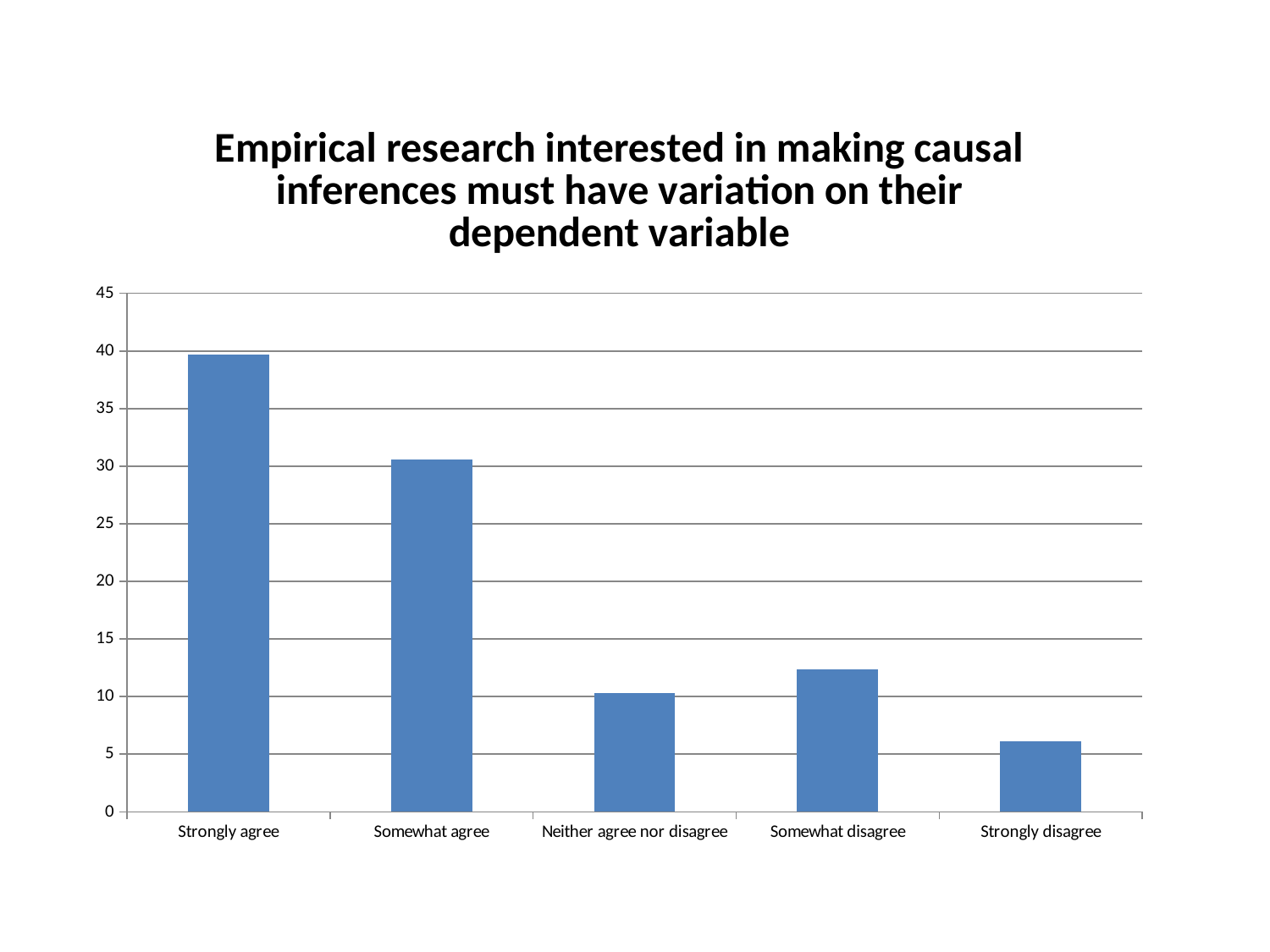
What kind of chart is shown on the slide? bar chart Is the value for Somewhat agree greater or less than 25? greater Is the value for Strongly agree greater or less than 35? greater What is the title of the chart? Empirical research interested in making causal inferences must have variation on their dependent variable Is the value for Somewhat disagree greater or less than 10? greater Which category has the highest value? Strongly agree Which is larger, the value for Strongly agree or the value for Somewhat agree? Strongly agree Which category has the lowest value? Strongly disagree Which is larger, the value for Somewhat disagree or the value for Neither agree nor disagree? Somewhat disagree How many categories are shown on the x axis? 5